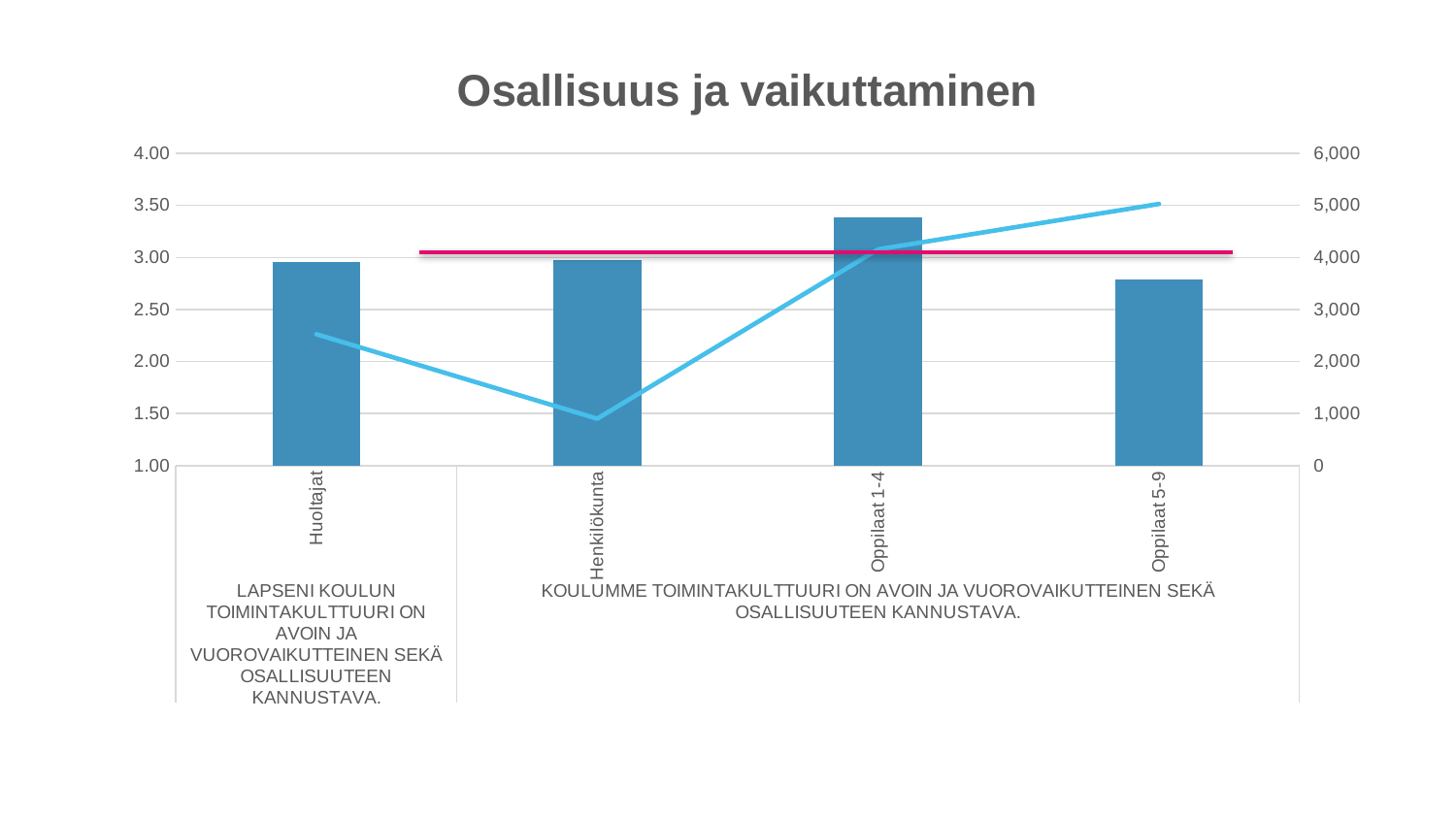
Is the bar value for Oppilaat 1-4 greater or less than 3.00 on the left axis? greater Which bar is taller, Oppilaat 1-4 or Oppilaat 5-9? Oppilaat 1-4 What kind of chart is shown on the slide? A combined bar and line chart Which category has the shortest bar? Oppilaat 5-9 At which category does the blue line reach its lowest point? Henkilökunta At which category does the blue line reach its highest point? Oppilaat 5-9 How many categories are shown along the x axis? 4 Is the blue line value for Oppilaat 5-9 greater or less than 4,000 on the right axis? greater Which category has the tallest bar? Oppilaat 1-4 Is the bar value for Oppilaat 5-9 greater or less than 3.00 on the left axis? less What is the title of the chart? Osallisuus ja vaikuttaminen